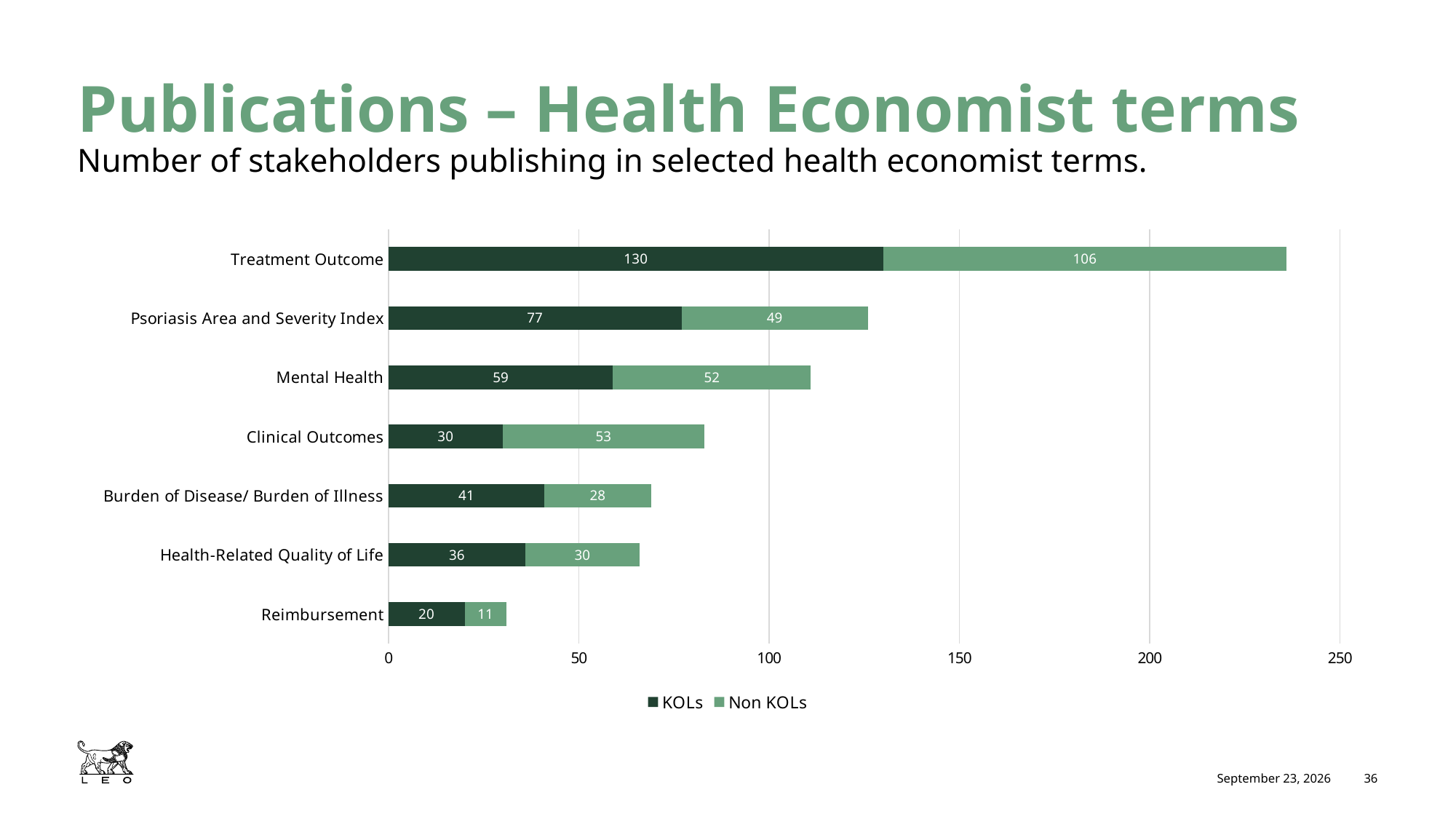
How many categories are shown on the chart? 7 What is the total of the stacked bar for Treatment Outcome? 236 What kind of chart is shown on the slide? Stacked bar chart What is the Non KOLs value for Clinical Outcomes? 53 What is the Non KOLs value for Reimbursement? 11 How many series does the legend list? 2 Which category has the lowest Non KOLs value? Reimbursement Which category has the highest KOLs value? Treatment Outcome What is the KOLs value for Treatment Outcome? 130 What is the total of the stacked bar for Health-Related Quality of Life? 66 What is the difference between the KOLs and Non KOLs values for Psoriasis Area and Severity Index? 28 Which is larger for Mental Health, the KOLs value or the Non KOLs value? KOLs